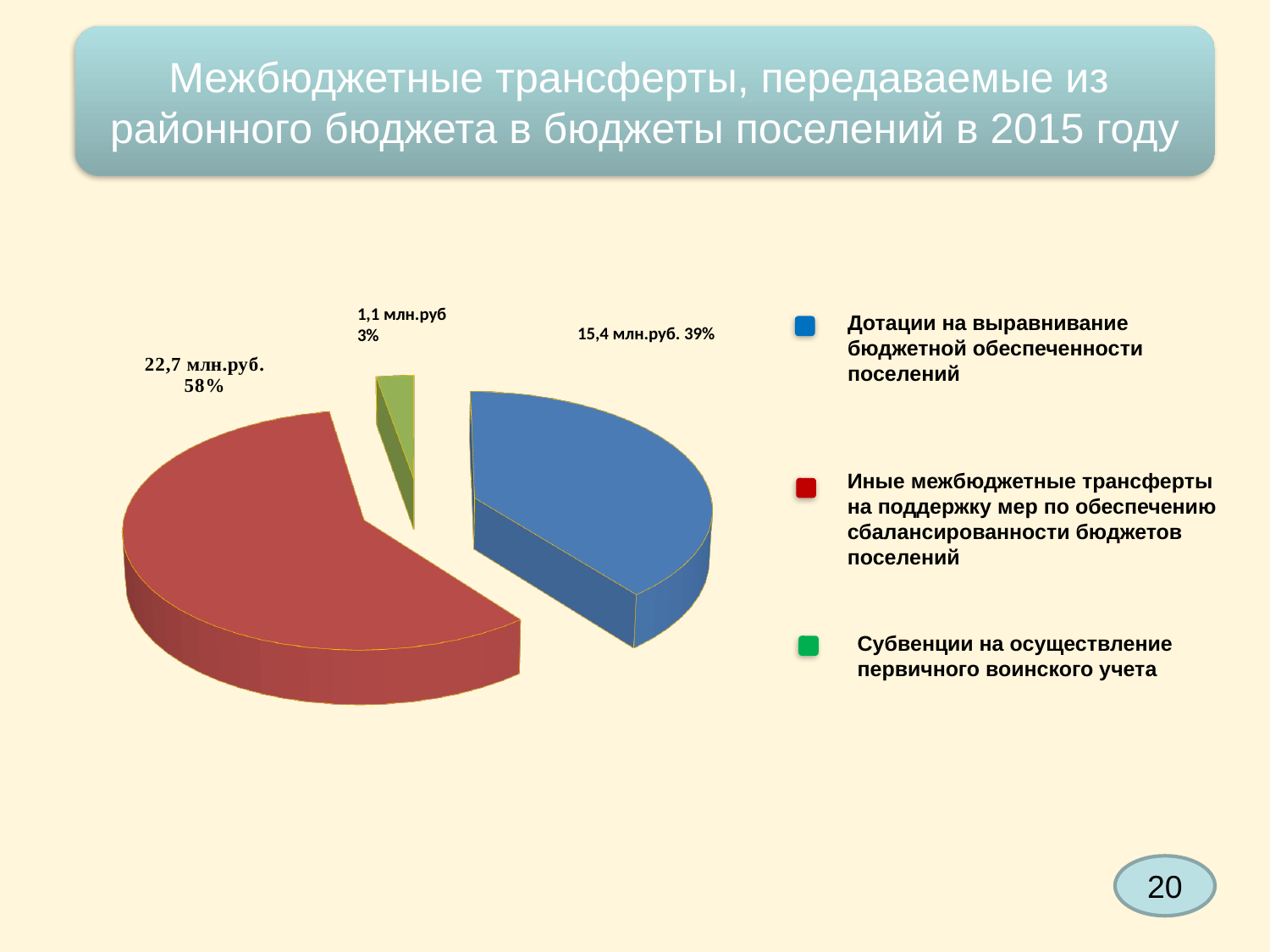
Что больше: дотации на выравнивание бюджетной обеспеченности поселений или субвенции на осуществление первичного воинского учета? Дотации на выравнивание бюджетной обеспеченности поселений Какая категория имеет наименьшую долю на диаграмме? Субвенции на осуществление первичного воинского учета Сколько категорий (секторов) показано на круговой диаграмме? 3 Какая категория имеет наибольшую долю на диаграмме? Иные межбюджетные трансферты на поддержку мер по обеспечению сбалансированности бюджетов поселений Какова сумма дотаций на выравнивание бюджетной обеспеченности поселений? 15,4 млн.руб. На сколько млн.руб. иные межбюджетные трансферты превышают дотации на выравнивание бюджетной обеспеченности поселений? 7,3 млн.руб. Какую долю круговой диаграммы занимают дотации на выравнивание бюджетной обеспеченности поселений? 39% Какую долю круговой диаграммы занимают субвенции на осуществление первичного воинского учета? 3% Какова сумма иных межбюджетных трансфертов на поддержку мер по обеспечению сбалансированности бюджетов поселений? 22,7 млн.руб. Каким цветом на диаграмме обозначены субвенции на осуществление первичного воинского учета? Зелёным Какой тип диаграммы показан на слайде? Круговая диаграмма Какова сумма субвенций на осуществление первичного воинского учета? 1,1 млн.руб